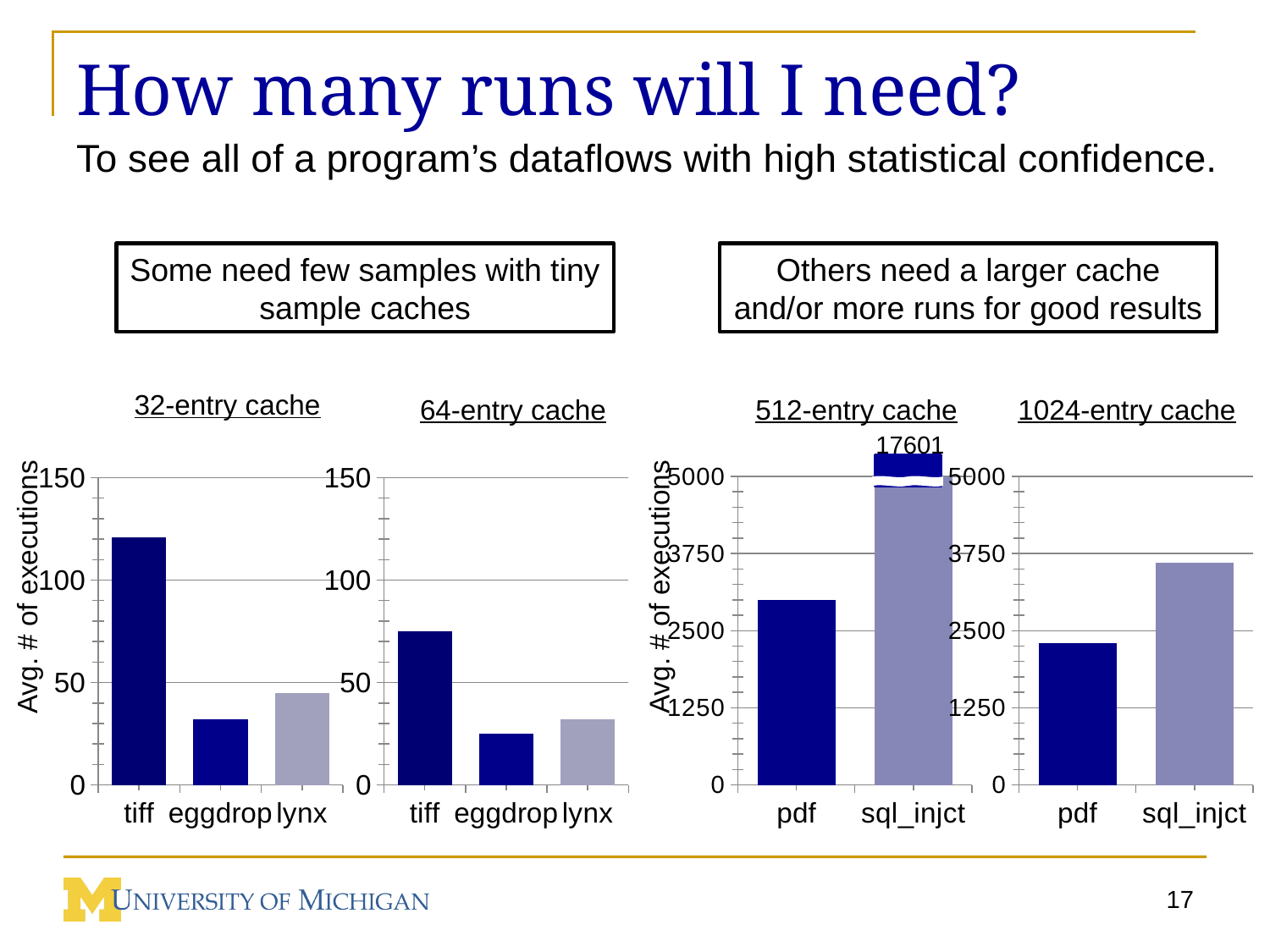
In the 32-entry cache chart, which category has the lowest value? eggdrop In the 64-entry cache chart, which category has the highest value? tiff How many categories are shown in the 32-entry cache chart? 3 In the 512-entry cache chart, is the value for pdf greater or less than 2500? greater What is the y-axis label of the 32-entry cache chart? Avg. # of executions In the 64-entry cache chart, is the value for tiff greater or less than 100? less In the 1024-entry cache chart, which is larger, pdf or sql_injct? sql_injct In the 32-entry cache chart, which category has the highest value? tiff In the 1024-entry cache chart, is the value for pdf greater or less than 2500? less What kind of chart is the 512-entry cache chart? bar chart In the 512-entry cache chart, what is the value for sql_injct? 17601